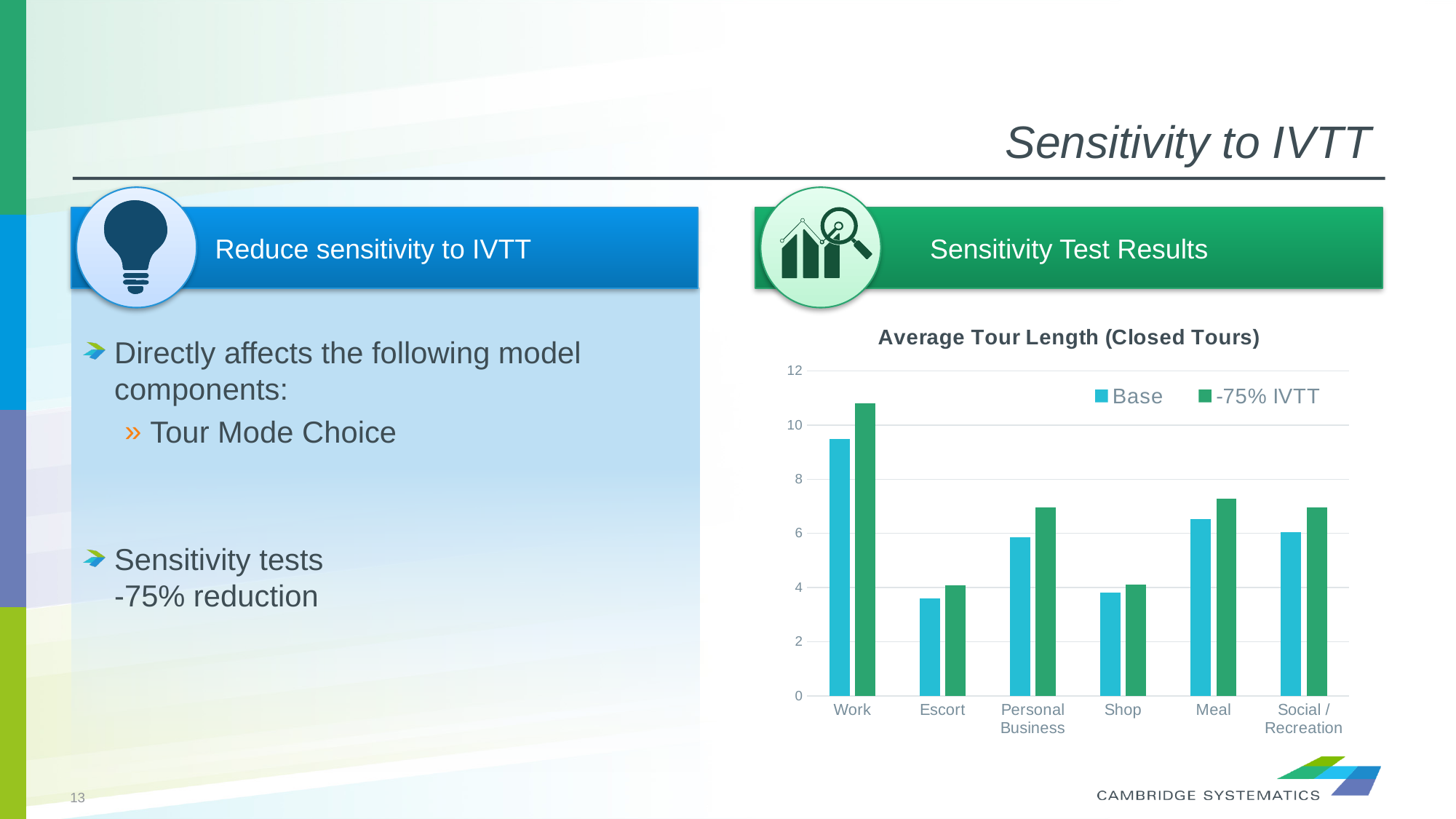
How many tour purpose categories are shown on the x axis of the chart? 6 Is the Base value for Escort greater or less than 4? less How many series does the chart's legend list? 2 Is the -75% IVTT value for Personal Business greater or less than 6? greater Which series is shown in green in the chart's legend? -75% IVTT What is the title of the chart on the slide? Average Tour Length (Closed Tours) Which is larger for Work: the Base value or the -75% IVTT value? -75% IVTT Which category has the highest Base value in the chart? Work What kind of chart is shown on the slide? bar chart Which category has the highest -75% IVTT value in the chart? Work Is the Base value for Work greater or less than 8? greater